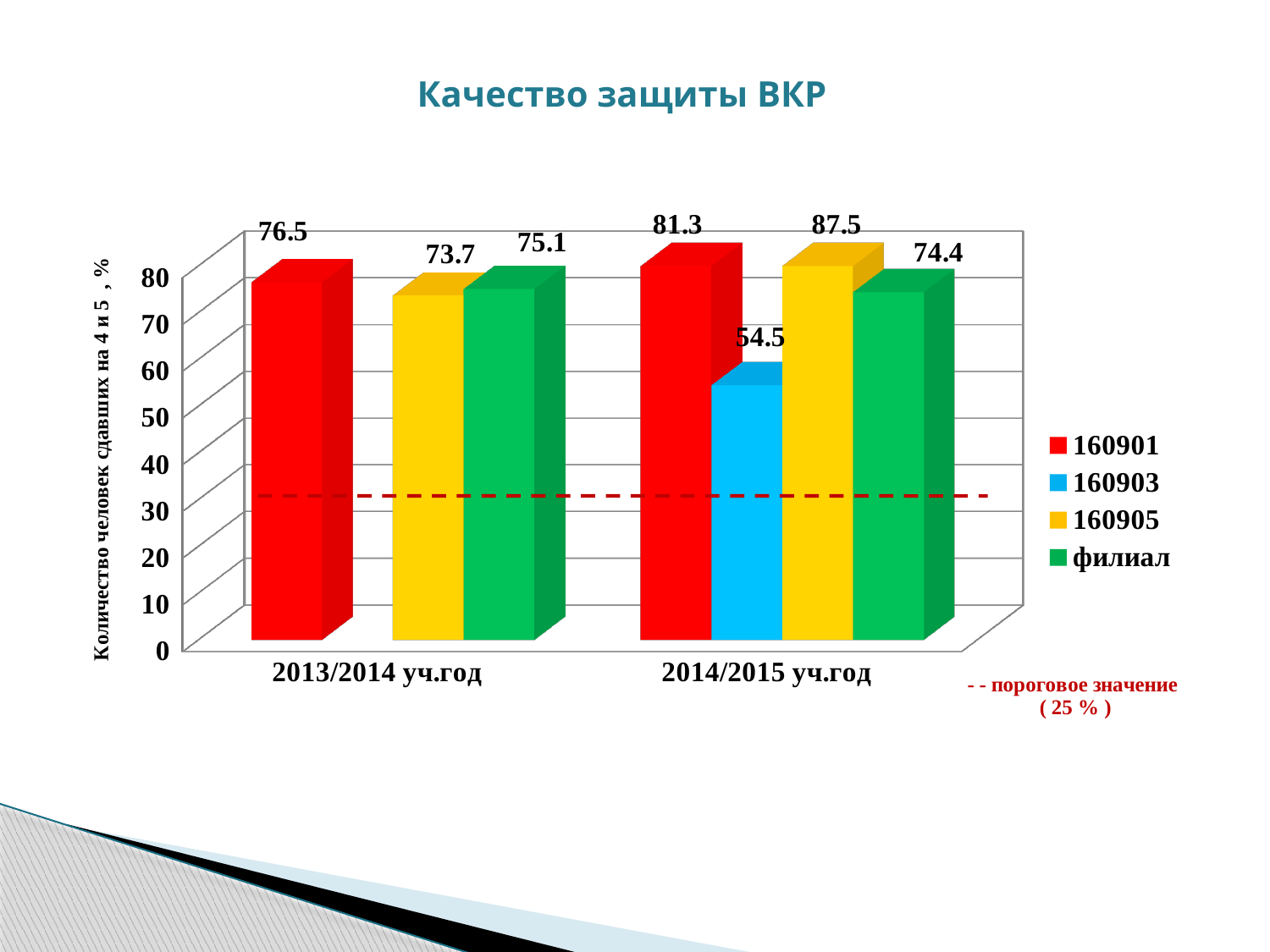
Which series has the highest value in 2014/2015 уч.год? 160905 Which is larger: the value for 160905 in 2013/2014 уч.год or the value for 160905 in 2014/2015 уч.год? 2014/2015 уч.год What kind of chart is shown on the slide? bar chart What is the value for 160903 in 2014/2015 уч.год? 54.5 What is the value for 160901 in 2013/2014 уч.год? 76.5 How many series does the legend list? 4 What is the title of the chart? Качество защиты ВКР What is the value for 160905 in 2014/2015 уч.год? 87.5 Which series has the lowest value in 2014/2015 уч.год? 160903 How many categories are shown on the x axis? 2 What is the value for филиал in 2013/2014 уч.год? 75.1 What is the difference between the 160901 values for 2014/2015 уч.год and 2013/2014 уч.год? 4.8